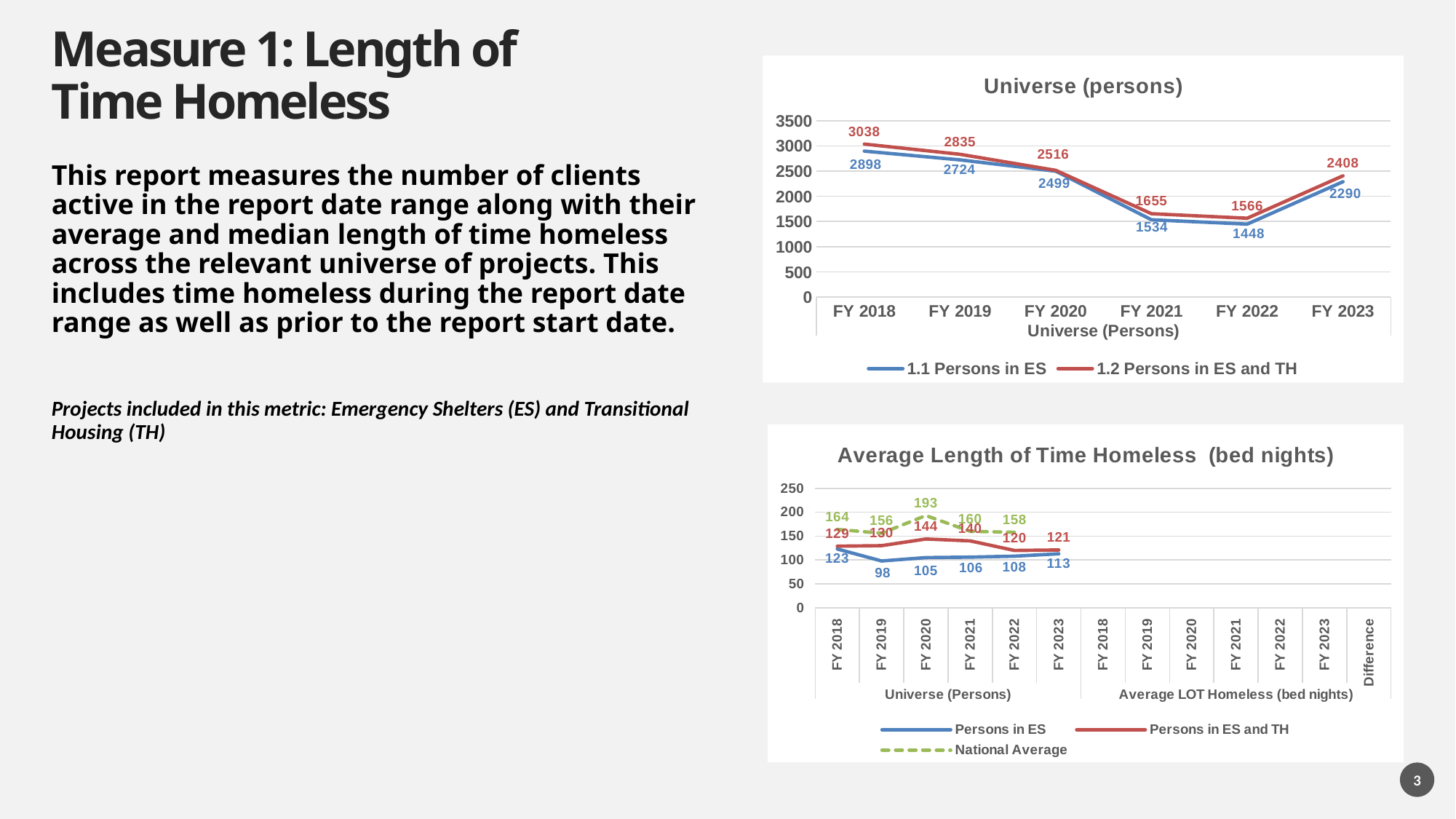
In the 'Average Length of Time Homeless (bed nights)' chart, what is the National Average value for FY 2020? 193 In the 'Universe (persons)' chart, what is the value for 1.2 Persons in ES and TH in FY 2023? 2408 In the 'Average Length of Time Homeless (bed nights)' chart, how many series does the legend list? 3 What kind of chart is the 'Average Length of Time Homeless (bed nights)' chart? line chart In the 'Universe (persons)' chart, which fiscal year has the highest value for 1.2 Persons in ES and TH? FY 2018 In the 'Universe (persons)' chart, do the values for 1.1 Persons in ES rise or fall from FY 2018 to FY 2022? fall In the 'Universe (persons)' chart, what is the difference between 1.2 Persons in ES and TH and 1.1 Persons in ES in FY 2021? 121 In the 'Universe (persons)' chart, how many series does the legend list? 2 In the 'Universe (persons)' chart, which fiscal year has the lowest value for 1.1 Persons in ES? FY 2022 In the 'Average Length of Time Homeless (bed nights)' chart, which is larger in FY 2022: Persons in ES and TH or National Average? National Average In the 'Average Length of Time Homeless (bed nights)' chart, what is the value for Persons in ES in FY 2019? 98 In the 'Universe (persons)' chart, what is the value for 1.1 Persons in ES in FY 2020? 2499